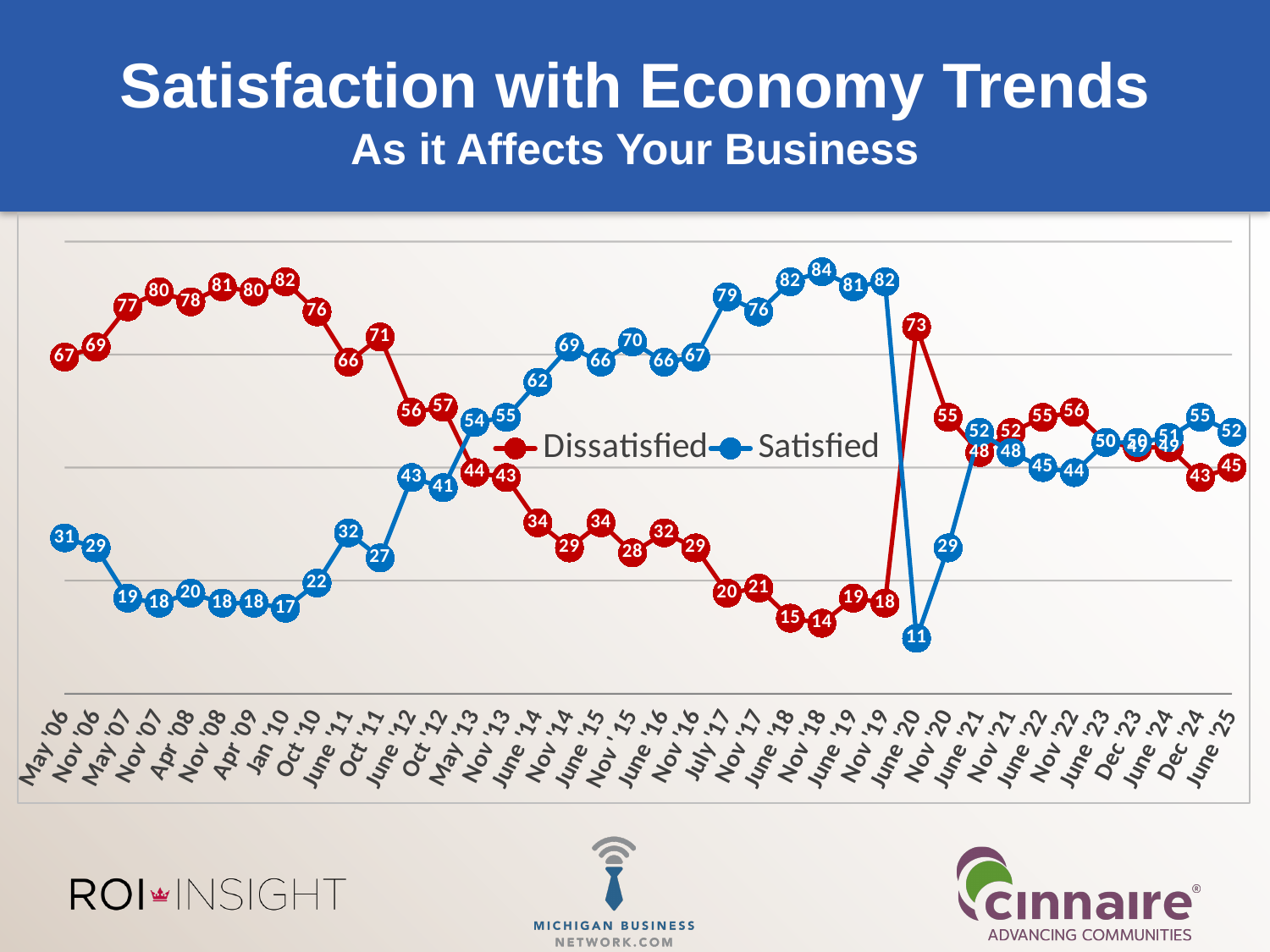
How many series does the legend list? 2 What is the Dissatisfied value for Dec '24? 43 What are the two entries in the chart legend? Dissatisfied and Satisfied At which date does the Dissatisfied series reach its lowest value? Nov '18 For May '06, which series has the larger value, Dissatisfied or Satisfied? Dissatisfied At which date does the Satisfied series reach its highest value? Nov '18 What is the Satisfied value for June '20? 11 What is the difference between the Satisfied and Dissatisfied values for June '25? 7 What kind of chart is shown on the slide? Line chart Does the Satisfied series rise or fall from May '06 to Jan '10? Fall What is the Dissatisfied value for June '20? 73 What is the Dissatisfied value for Jan '10? 82